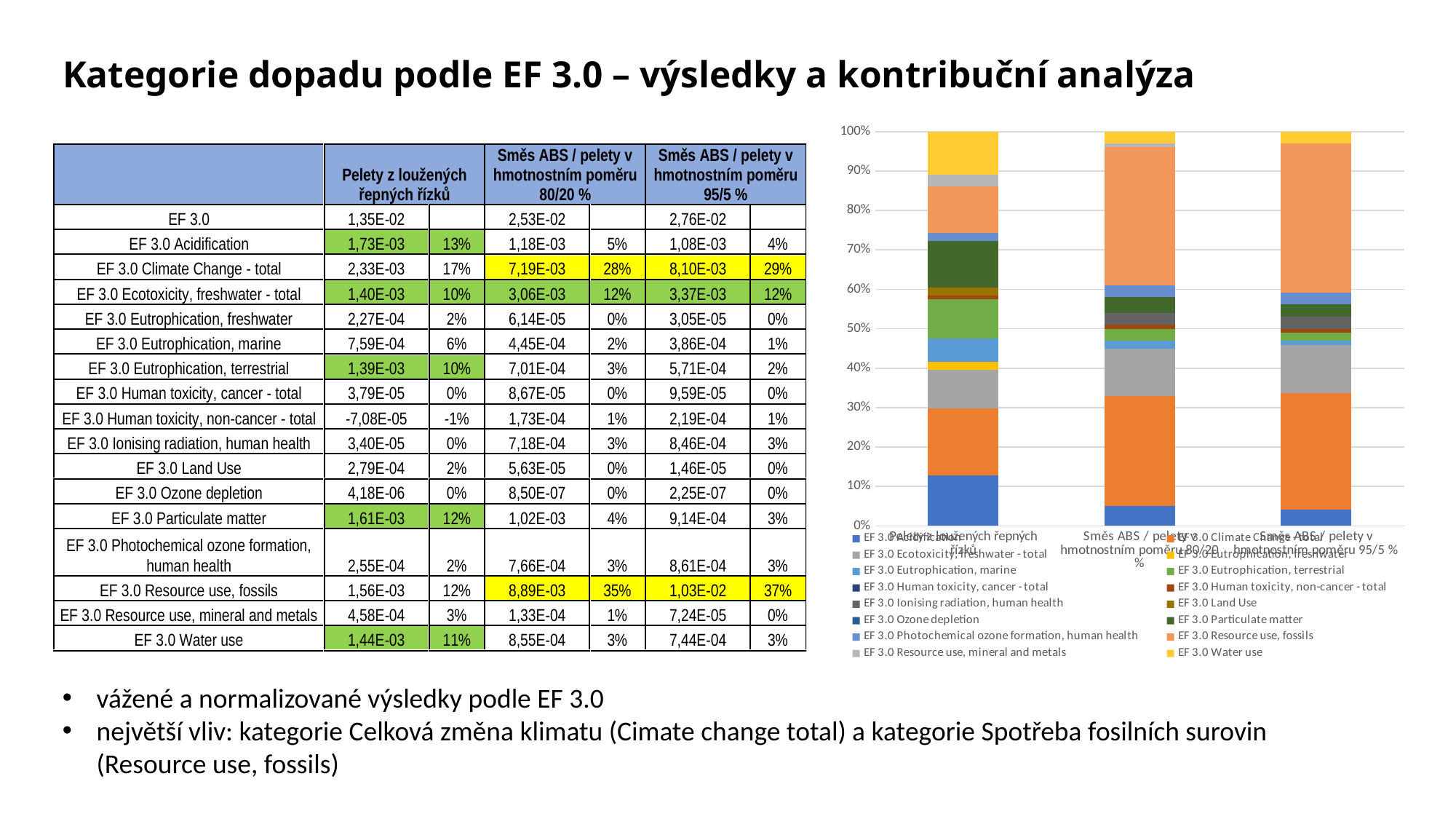
How many series does the legend of the stacked bar chart list? 16 What is the highest value shown on the vertical axis of the stacked bar chart? 100% In the stacked bar chart, is the EF 3.0 Water use segment of the 'Směs ABS / pelety v hmotnostním poměru 80/20 %' bar greater or less than 10%? less In the stacked bar chart, is the EF 3.0 Resource use, fossils segment larger in the 'Pelety z loužených řepných řízků' bar or in the 'Směs ABS / pelety v hmotnostním poměru 80/20 %' bar? Směs ABS / pelety v hmotnostním poměru 80/20 % In the stacked bar chart, which series forms the largest segment of the 'Směs ABS / pelety v hmotnostním poměru 80/20 %' bar? EF 3.0 Resource use, fossils What is the first entry in the legend of the stacked bar chart? EF 3.0 Acidification How many bars does the stacked bar chart contain? 3 In the stacked bar chart, is the EF 3.0 Resource use, fossils segment of the 'Směs ABS / pelety v hmotnostním poměru 80/20 %' bar greater or less than 30%? greater In the stacked bar chart, is the EF 3.0 Acidification segment of the 'Pelety z loužených řepných řízků' bar greater or less than 10%? greater In the stacked bar chart, which bar has the largest EF 3.0 Acidification segment? Pelety z loužených řepných řízků What kind of chart is shown on the right of the slide? stacked bar chart